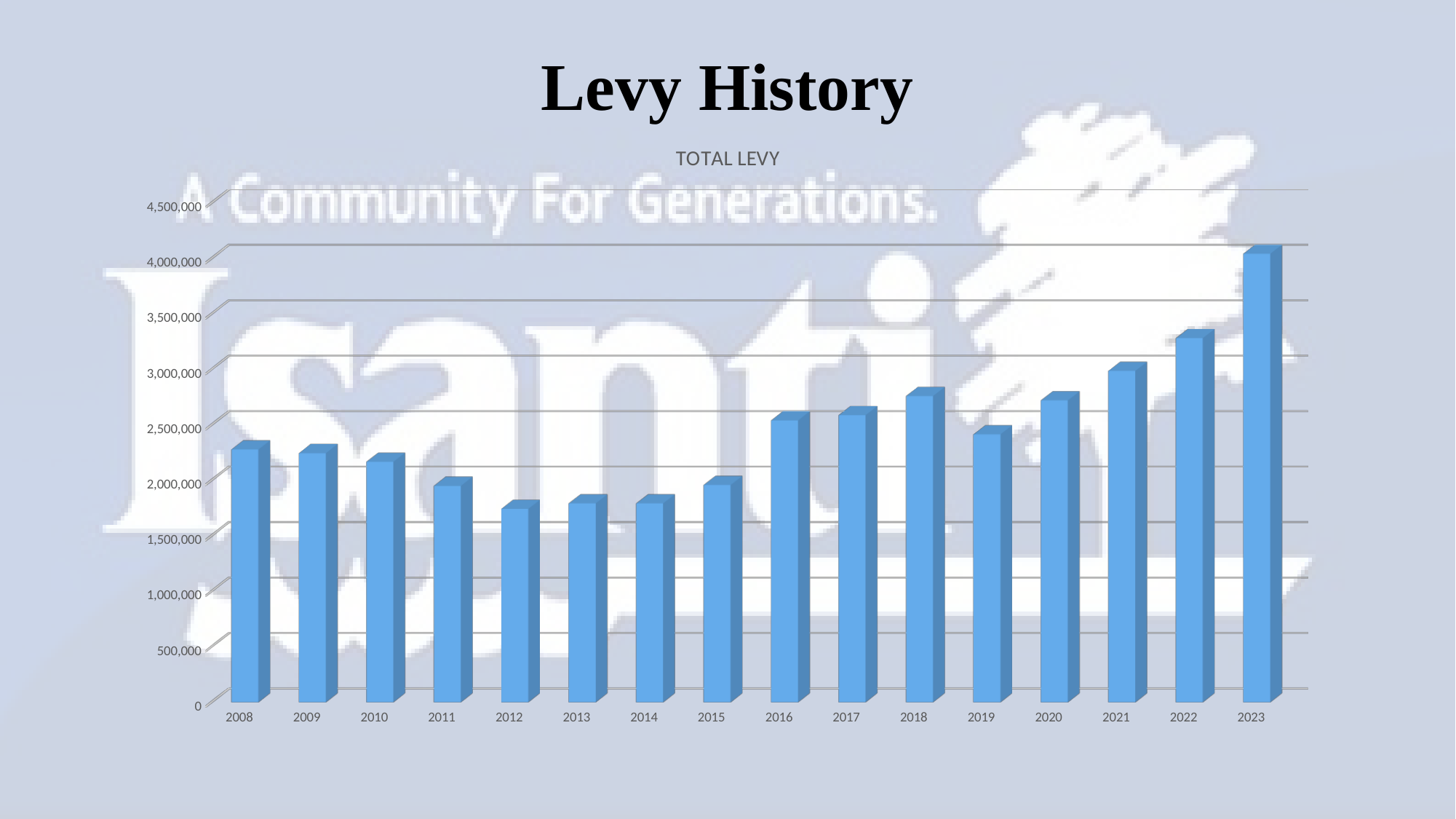
Which is larger, the total levy for 2010 or for 2011? 2010 Do the values rise or fall from 2019 to 2023? rise How many years are shown on the x axis of the chart? 16 Which is larger, the total levy for 2018 or for 2019? 2018 Do the values rise or fall from 2008 to 2012? fall Which year has the highest total levy? 2023 What kind of chart is shown on the slide? bar chart Is the value for 2023 greater or less than 3,500,000? greater Is the value for 2008 greater or less than 2,000,000? greater Is the value for 2012 greater or less than 2,000,000? less What is the title of the chart? TOTAL LEVY